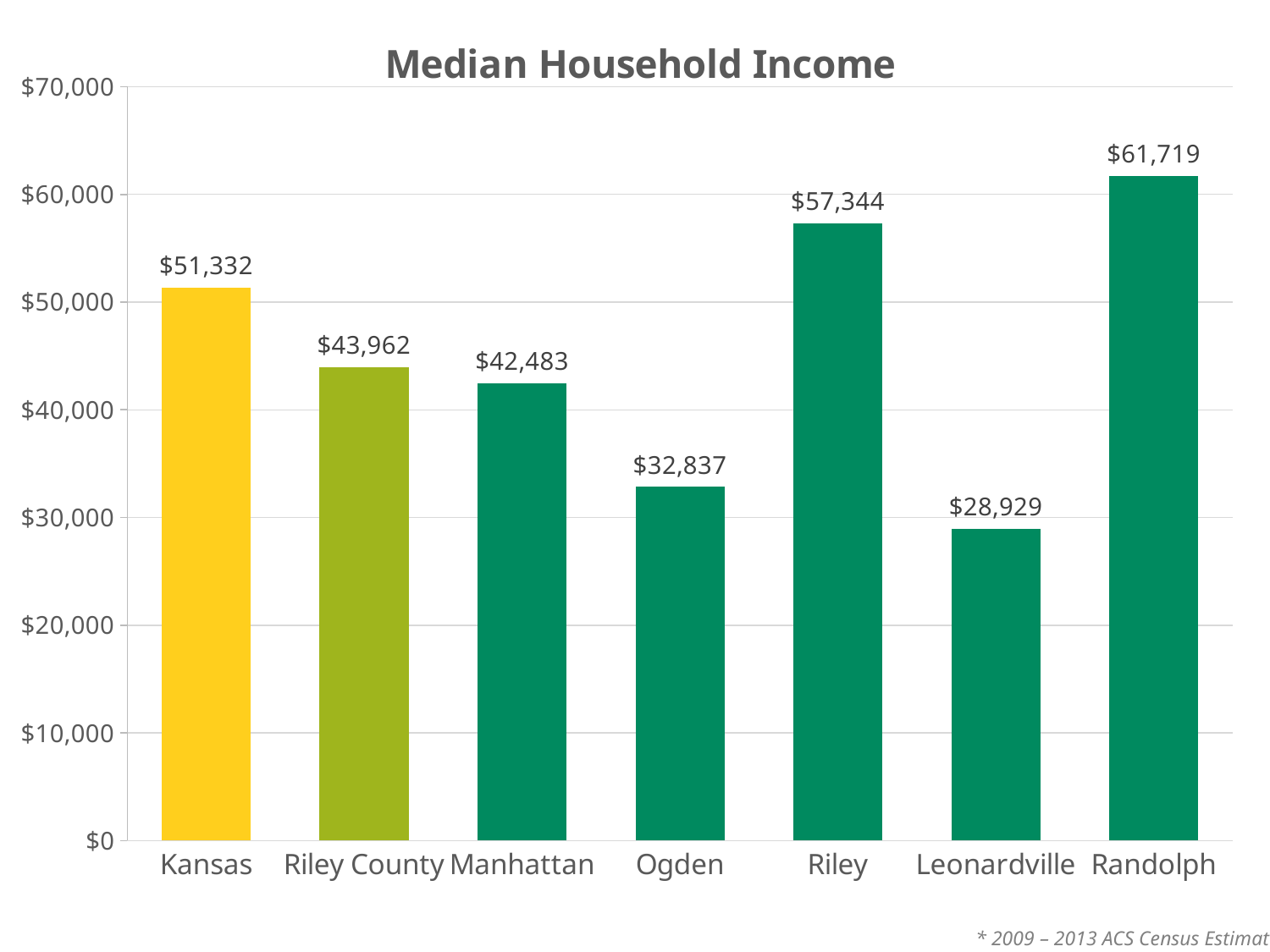
What is the median household income for Ogden? $32,837 What kind of chart is shown on the slide? Bar chart Which category has the lowest median household income? Leonardville Which has a higher median household income, Riley County or Manhattan? Riley County How many categories are shown in the chart? 7 What is the title of the chart? Median Household Income What is the difference between the median household income of Randolph and Riley? $4,375 What is the median household income for Leonardville? $28,929 Is the value for Riley greater or less than $50,000? greater Which category has the highest median household income? Randolph What is the median household income for Kansas? $51,332 What is the difference between the median household income of Kansas and Manhattan? $8,849